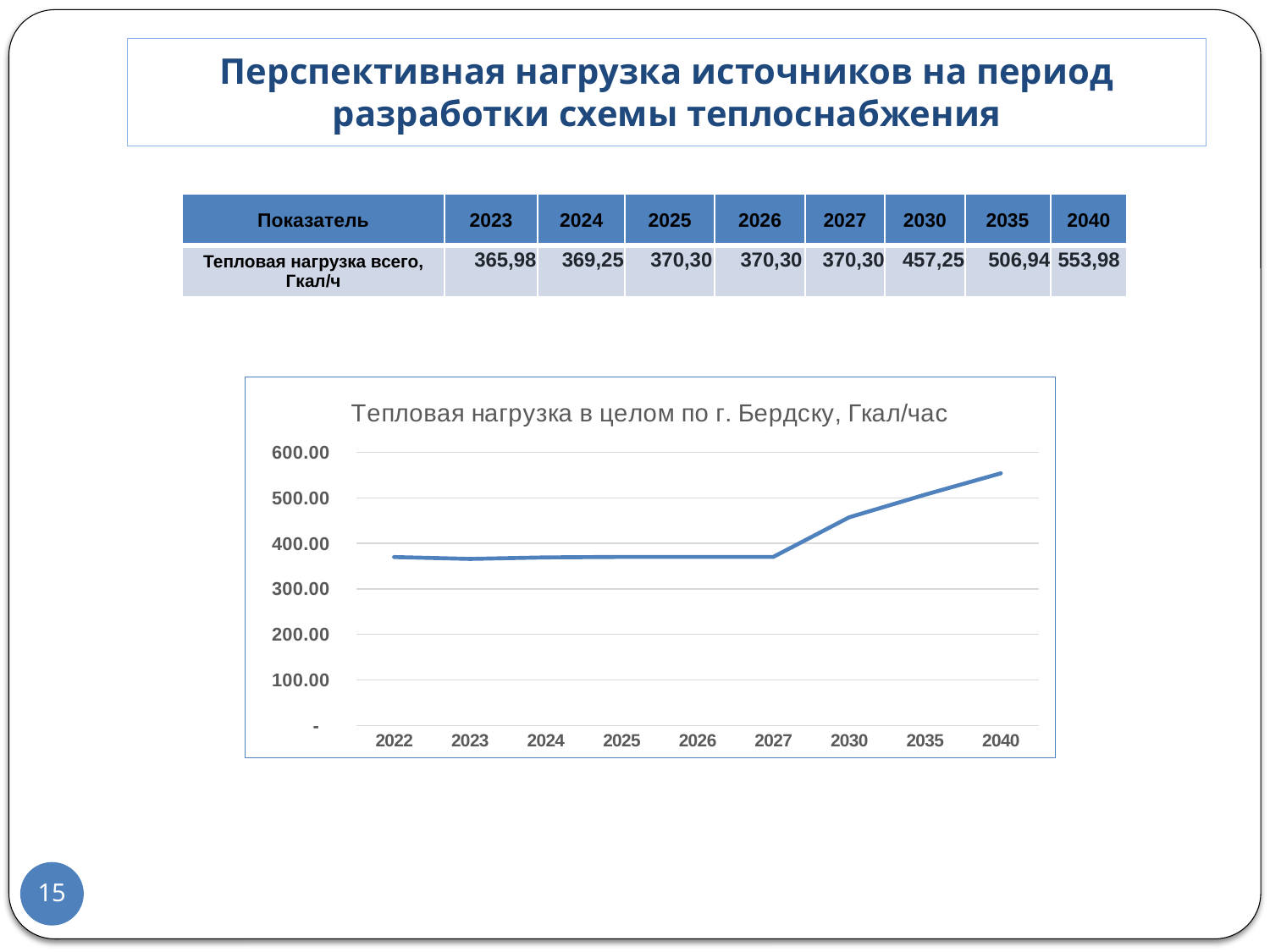
Is the value for 2030 in the chart greater or less than 400? greater According to the table, what is the total heat load (Тепловая нагрузка всего, Гкал/ч) for 2023? 365,98 Using the table values, what is the difference between the heat load in 2040 and in 2023? 188,00 How many years are marked on the x axis of the chart? 9 Which year has the highest value in the chart? 2040 Which is larger, the value for 2030 or the value for 2027? 2030 What kind of chart is shown on the slide? line chart According to the table, what is the total heat load for 2040? 553,98 Is the value for 2027 in the chart greater or less than 400? less Is the value for 2040 in the chart greater or less than 500? greater What is the title of the chart? Тепловая нагрузка в целом по г. Бердску, Гкал/час Do the values in the chart generally rise or fall from 2022 to 2040? rise